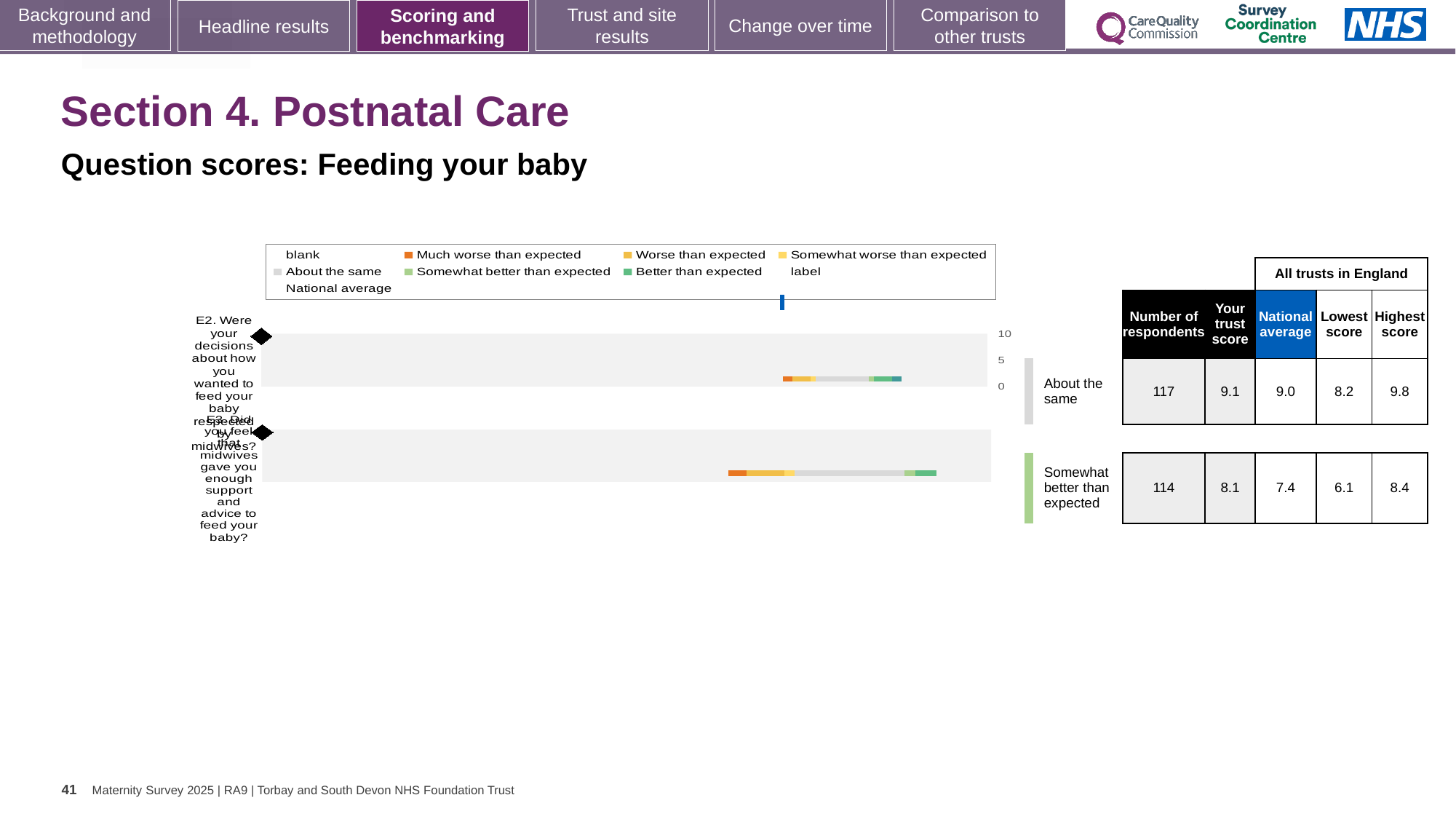
How many questions (bars) are plotted in the chart? 2 In the table beside the chart, how many respondents are listed for the row labelled 'About the same'? 117 What kind of chart is shown on the slide? bar chart In the table beside the chart, which row has the higher trust score: 'About the same' or 'Somewhat better than expected'? About the same Which benchmark label is shown next to the bar for E2 (decisions about how you wanted to feed your baby respected by midwives)? About the same In the table beside the chart, what is the trust score for the row labelled 'About the same'? 9.1 In the table beside the chart, what is the national average for the row labelled 'Somewhat better than expected'? 7.4 In the table beside the chart, which row has the lower number of respondents? Somewhat better than expected In the table beside the chart, by how much does the trust score exceed the national average for the row labelled 'Somewhat better than expected'? 0.7 In the table beside the chart, what is the lowest score for the row labelled 'About the same'? 8.2 In the table beside the chart, what is the highest score for the row labelled 'Somewhat better than expected'? 8.4 Which benchmark label is shown next to the bar for E3 (midwives gave you enough support and advice to feed your baby)? Somewhat better than expected